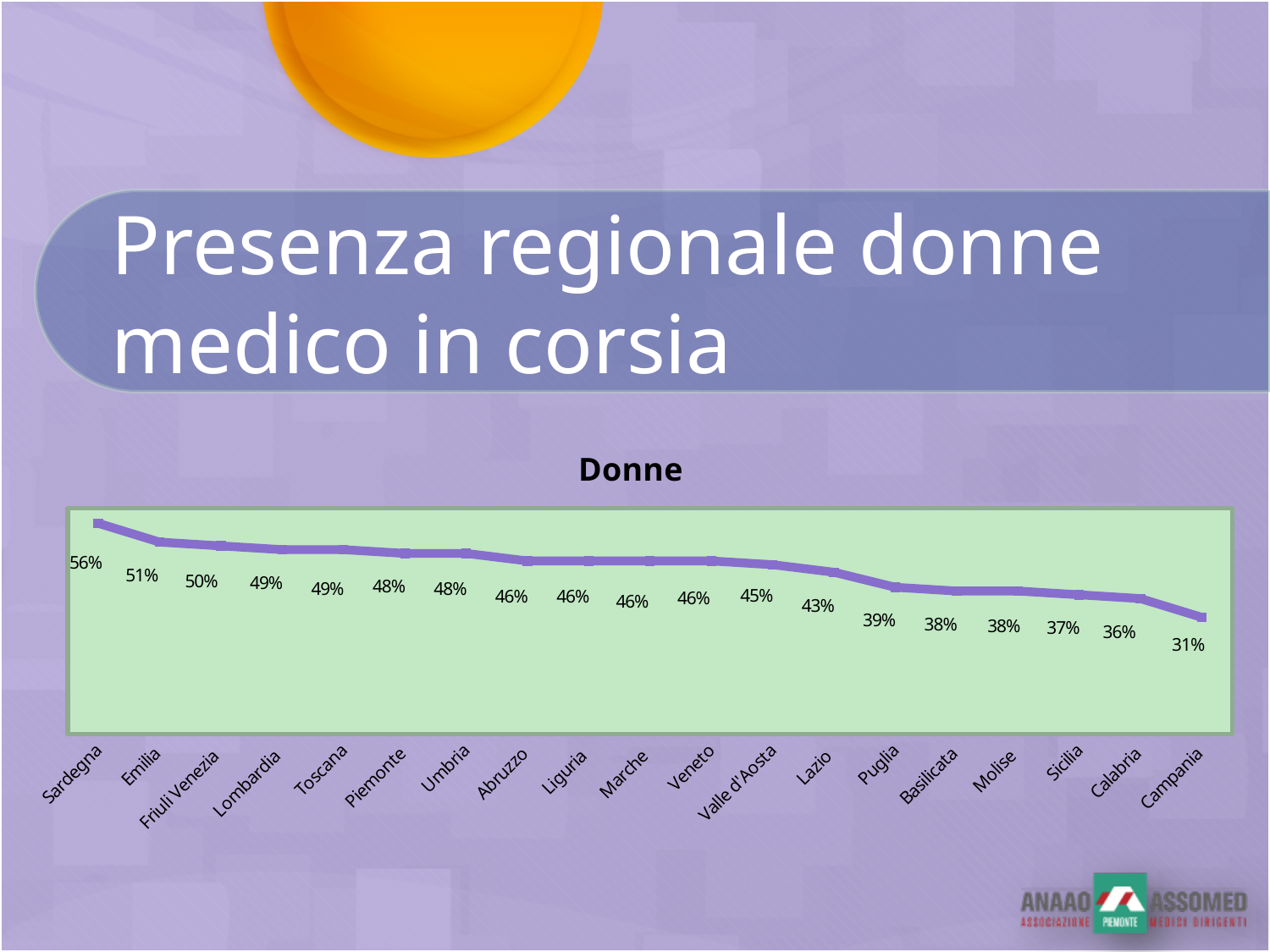
Do the values rise or fall from left to right along the x axis? Fall What is the value for Campania? 31% Which region has the lowest value? Campania What is the difference between the values for Emilia and Puglia? 12% What is the value for Sardegna? 56% How many regions are plotted on the chart? 19 What kind of chart is shown on the slide? Line chart Which region has the highest value? Sardegna Which has a larger value, Toscana or Sicilia? Toscana What is the value for Piemonte? 48% What is the difference between the values for Sardegna and Campania? 25% What is the value for Lazio? 43%